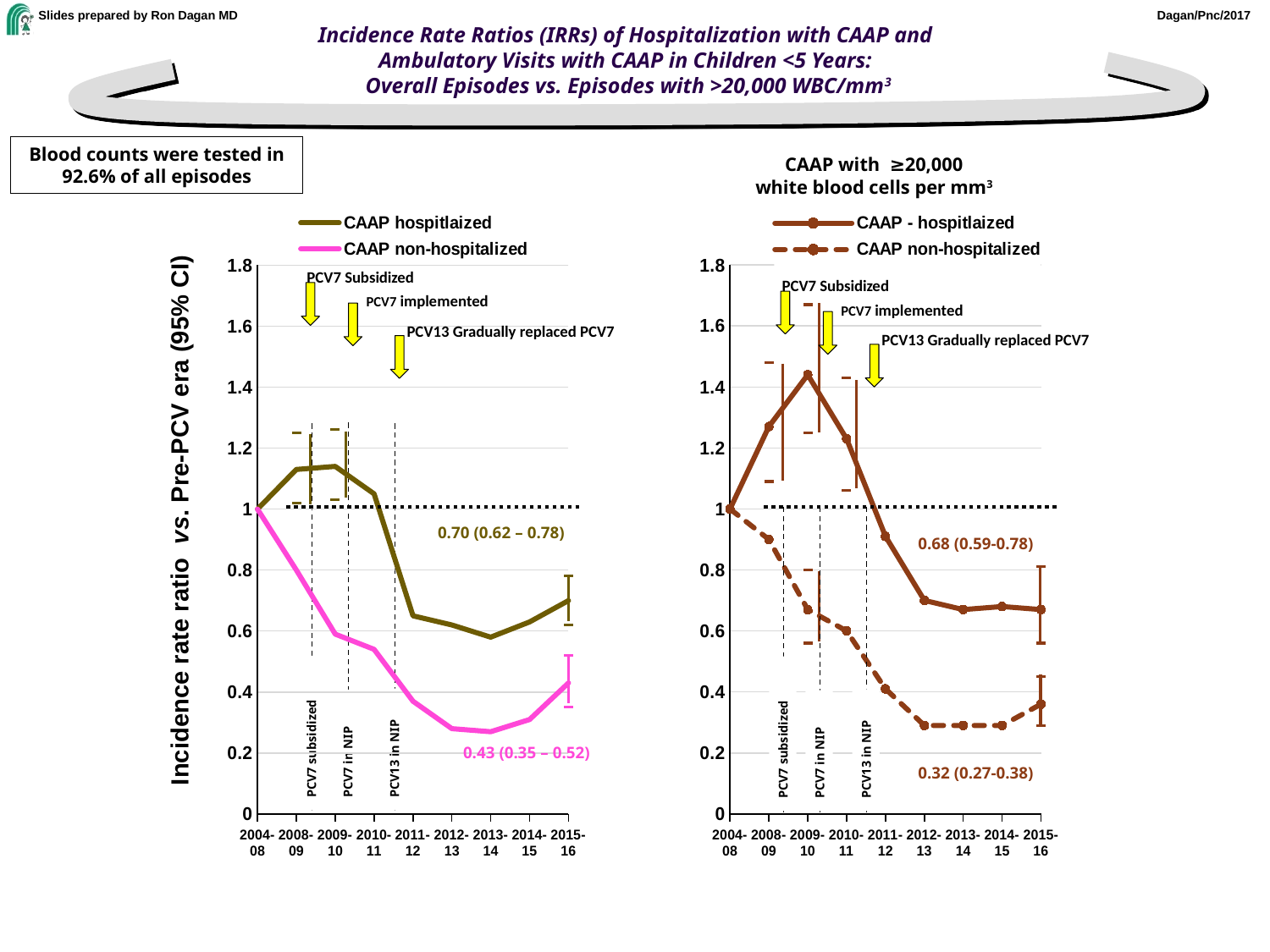
How many time periods are shown on the x axis of the right chart (CAAP with ≥20,000 white blood cells per mm³)? 9 In the left chart, does the CAAP non-hospitalized line rise or fall from 2004-08 to 2013-14? fall In the left chart, is the value for CAAP non-hospitalized in 2013-14 greater or less than 0.4? less What kind of chart is the left chart on the slide? line chart In the right chart (CAAP with ≥20,000 white blood cells per mm³), is the value for CAAP - hospitalized in 2009-10 greater or less than 1.2? greater In the left chart, what is the labelled incidence rate ratio (with 95% CI) for CAAP non-hospitalized in the final period? 0.43 (0.35 – 0.52) In the right chart (CAAP with ≥20,000 white blood cells per mm³), what is the labelled incidence rate ratio (with 95% CI) for CAAP - hospitalized? 0.68 (0.59-0.78) How many series does the legend of the right chart (CAAP with ≥20,000 white blood cells per mm³) list? 2 In the left chart, what is the labelled incidence rate ratio (with 95% CI) for CAAP hospitalized in the final period? 0.70 (0.62 – 0.78) In the right chart (CAAP with ≥20,000 white blood cells per mm³), which series has the higher incidence rate ratio in 2015-16? CAAP - hospitalized How many series does the legend of the left chart list? 2 In the right chart (CAAP with ≥20,000 white blood cells per mm³), what is the labelled incidence rate ratio (with 95% CI) for CAAP non-hospitalized? 0.32 (0.27-0.38)